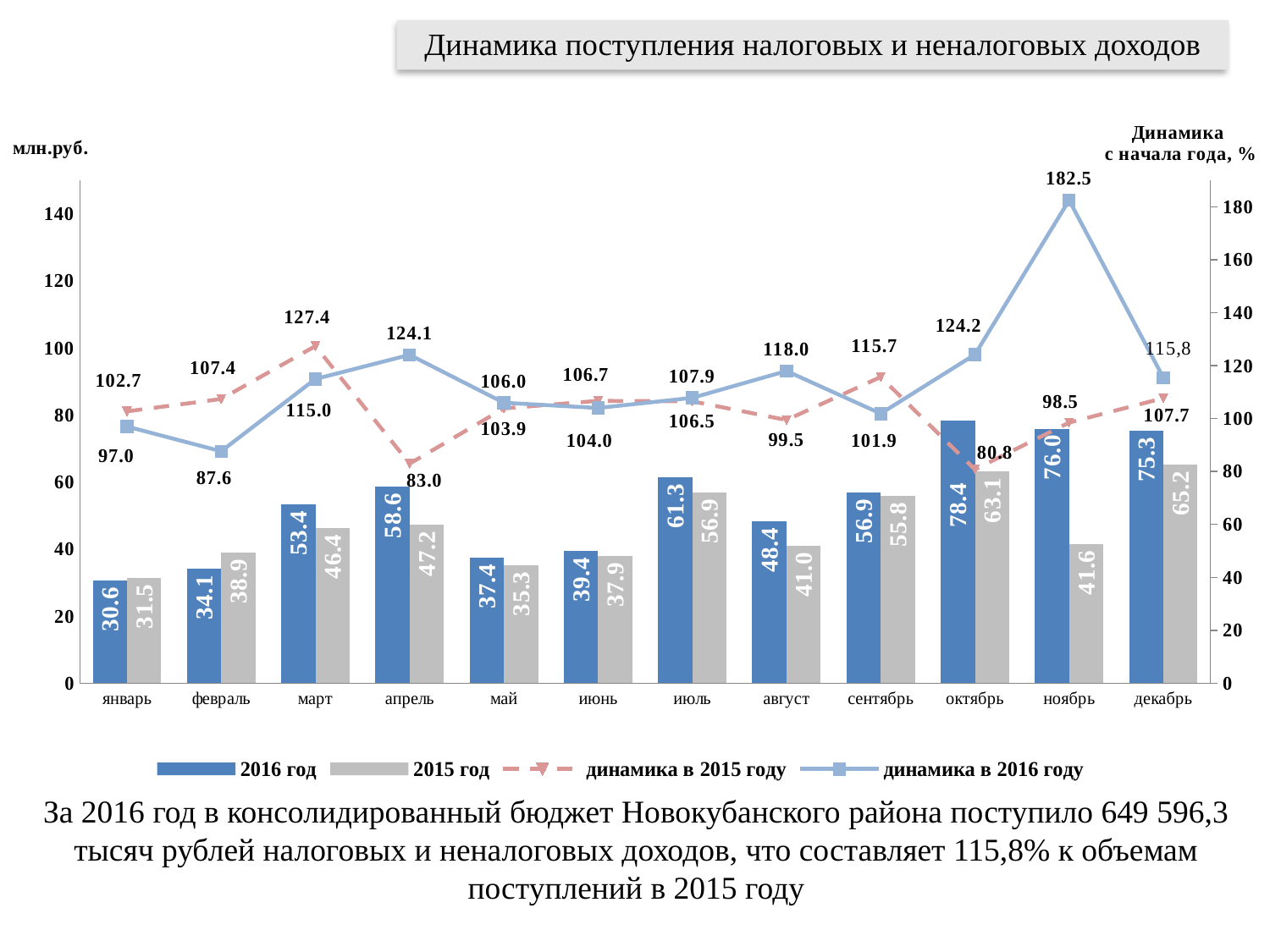
Which is larger for февраль, the 2016 год bar or the 2015 год bar? 2015 год What is the value of the 2016 год bar for октябрь? 78.4 What is the difference between the 2016 год and 2015 год bars for ноябрь? 34.4 How many months are shown on the x axis? 12 Which month has the lowest 2016 год bar? январь What is the value of the динамика в 2015 году line for март? 127.4 What is the value of the динамика в 2016 году line for ноябрь? 182.5 What is the value of the 2015 год bar for декабрь? 65.2 What kind of chart is this? Combined bar and line chart What is the unit shown on the left axis? млн.руб. How many series does the legend list? 4 Which month has the highest 2016 год bar? октябрь